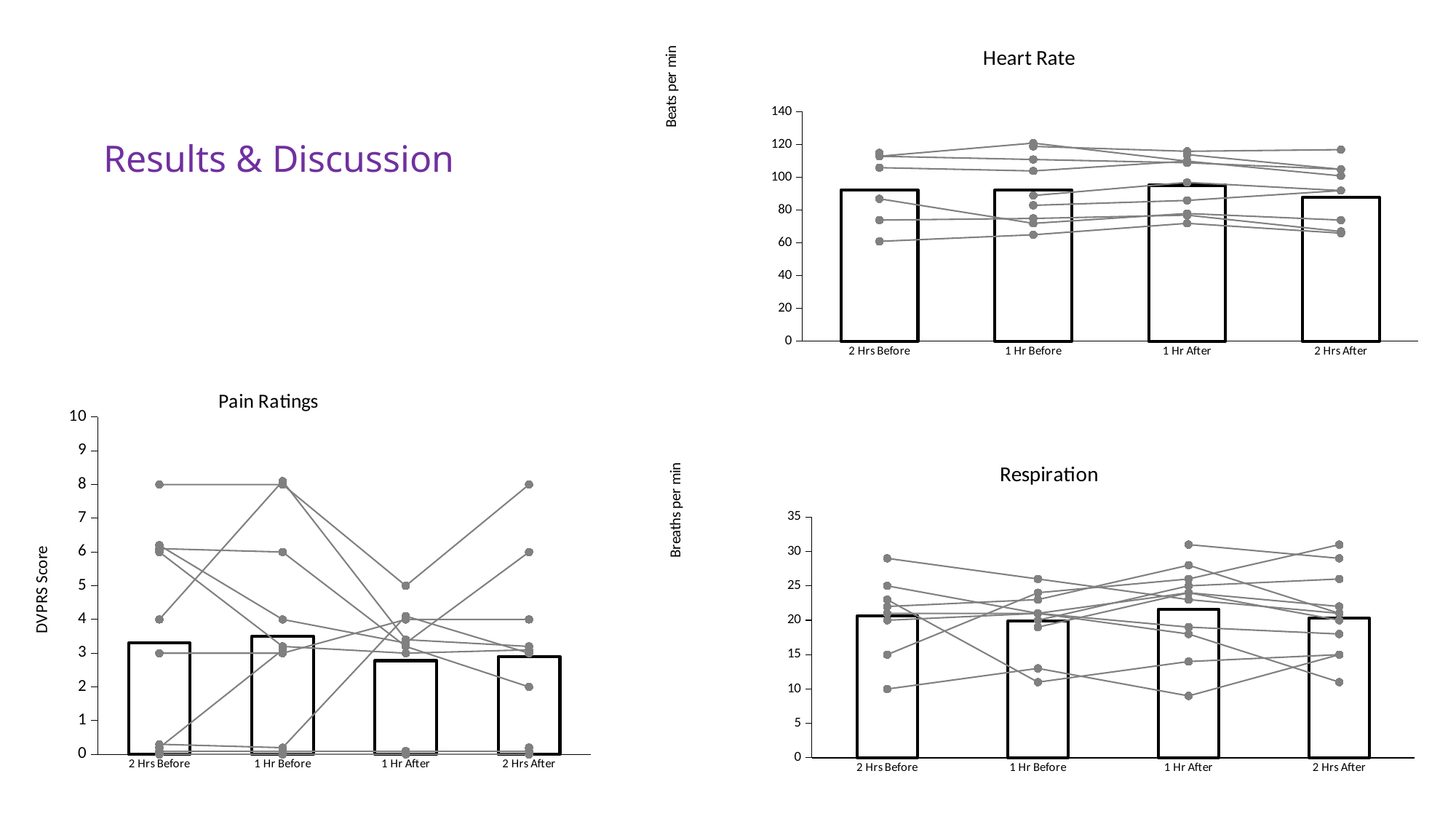
In the Heart Rate chart, is the bar for 1 Hr After greater or less than 80? greater In the Heart Rate chart, is the bar for 2 Hrs After greater or less than 100? less In the Respiration chart, which time point has the highest bar? 1 Hr After In the Heart Rate chart, which time point has the lowest bar? 2 Hrs After In the Pain Ratings chart, how many time-point categories are shown on the x axis? 4 In the Respiration chart, is the bar for 1 Hr After greater or less than 15? greater What is the y-axis label of the Pain Ratings chart? DVPRS Score In the Respiration chart, which is larger, the bar for 1 Hr After or the bar for 1 Hr Before? 1 Hr After What is the y-axis label of the Heart Rate chart? Beats per min In the Pain Ratings chart, which is larger, the bar for 1 Hr Before or the bar for 1 Hr After? 1 Hr Before